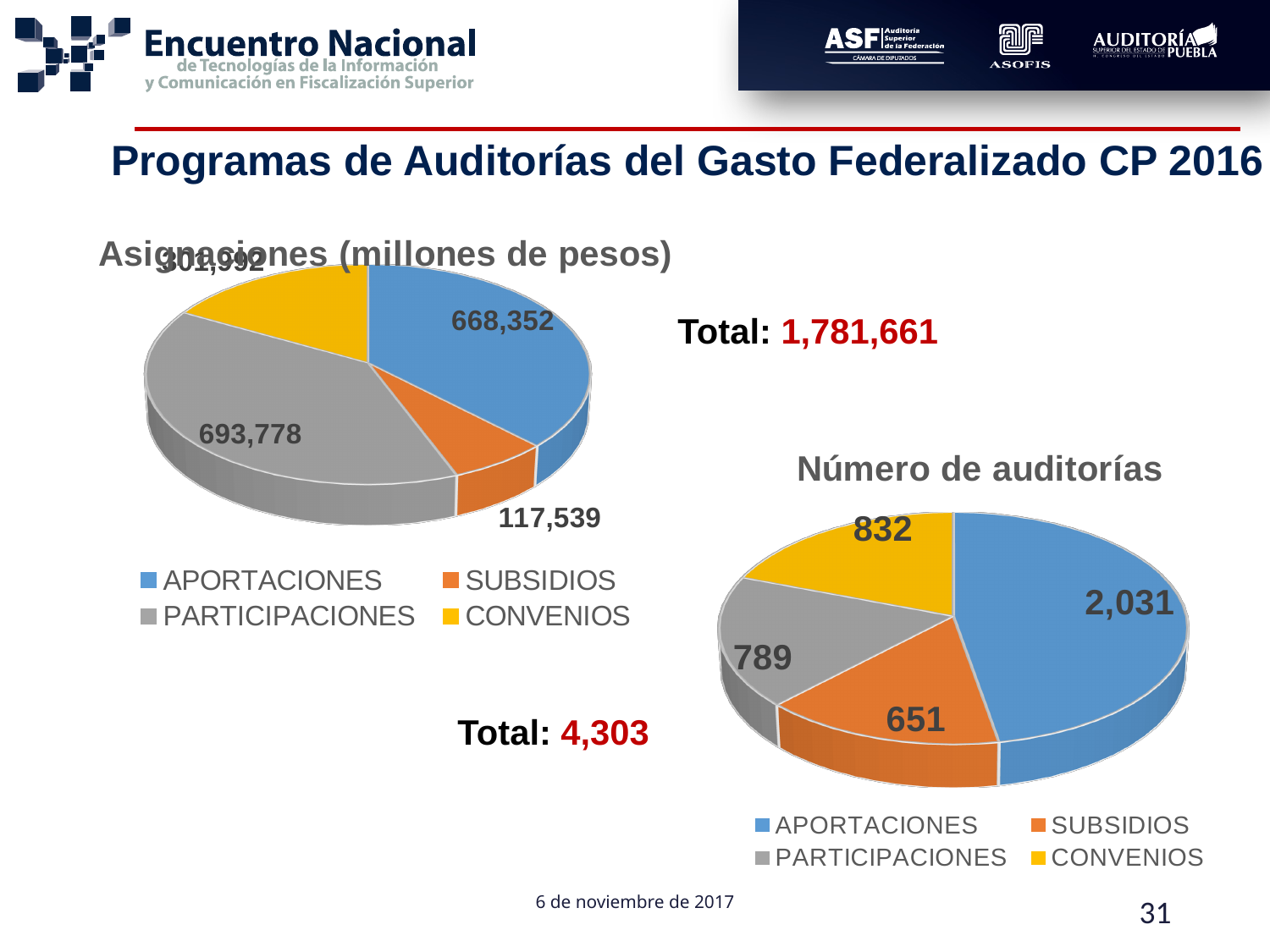
In the 'Número de auditorías' chart, what is the difference between APORTACIONES and SUBSIDIOS? 1,380 How many categories does the legend of the 'Asignaciones (millones de pesos)' chart list? 4 In the 'Número de auditorías' chart, which is larger, PARTICIPACIONES or CONVENIOS? CONVENIOS In the 'Número de auditorías' chart, which category has the largest value? APORTACIONES What total is printed next to the 'Número de auditorías' chart? 4,303 In the 'Asignaciones (millones de pesos)' chart, what is the value for PARTICIPACIONES? 693,778 In the 'Número de auditorías' chart, what is the value for SUBSIDIOS? 651 In the 'Asignaciones (millones de pesos)' chart, what is the value for SUBSIDIOS? 117,539 In the 'Número de auditorías' chart, what is the value for CONVENIOS? 832 In the 'Asignaciones (millones de pesos)' chart, which category has the smallest value? SUBSIDIOS In the 'Número de auditorías' chart, what is the value for APORTACIONES? 2,031 What kind of charts are shown on the slide? Pie charts